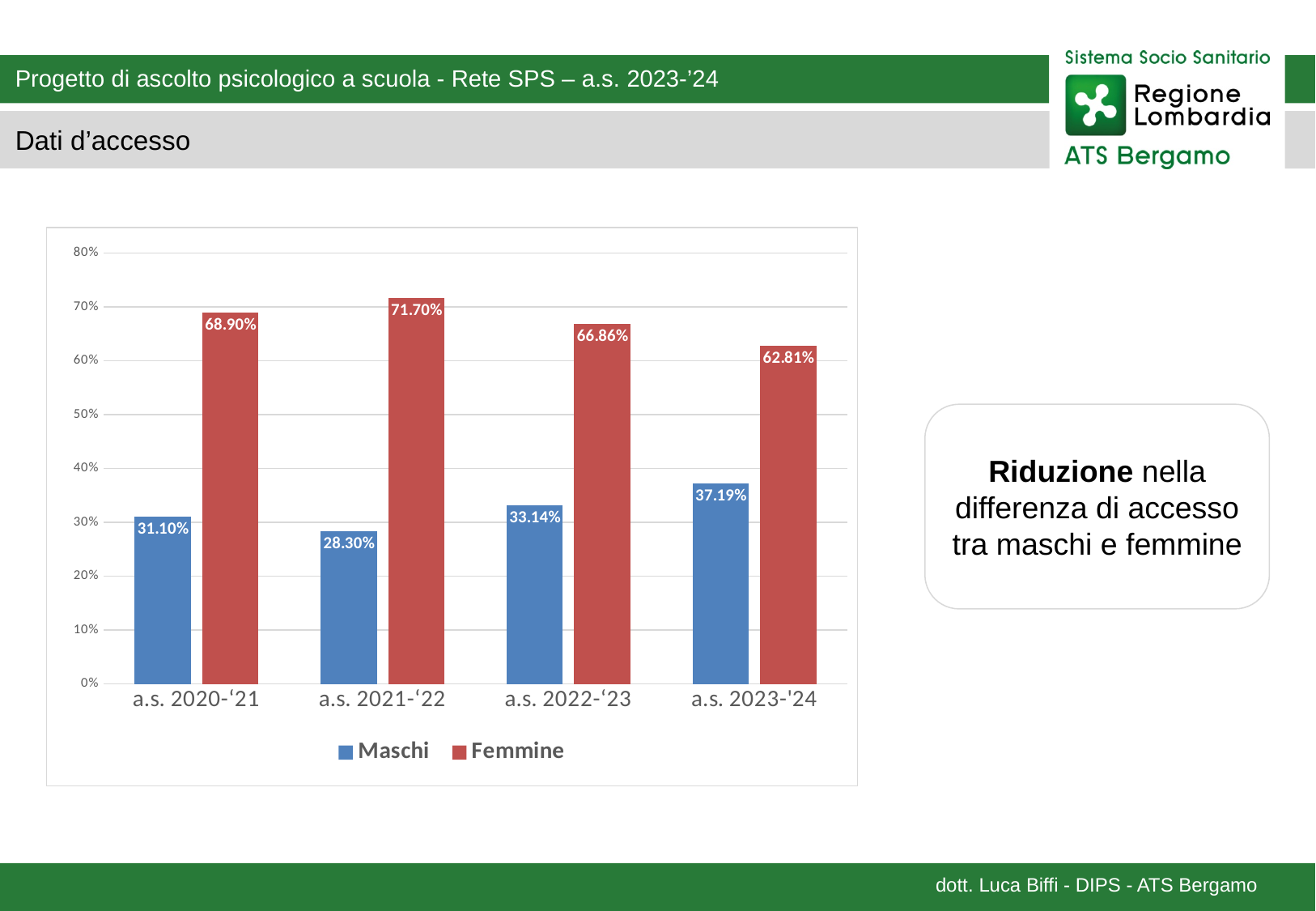
What is the value for Femmine in a.s. 2022-'23? 66.86% What kind of chart is shown on the slide? Bar chart What is the value for Maschi in a.s. 2020-'21? 31.10% Does the Femmine value rise or fall from a.s. 2021-'22 to a.s. 2023-'24? Fall What is the value for Femmine in a.s. 2021-'22? 71.70% In which school year is the Maschi value lowest? a.s. 2021-'22 How many series does the legend list? 2 In which school year is the Femmine value highest? a.s. 2021-'22 What is the difference between the Femmine and Maschi values in a.s. 2023-'24? 25.62% How many school years are shown on the x axis? 4 Which is larger in a.s. 2020-'21, the Maschi value or the Femmine value? Femmine What is the value for Maschi in a.s. 2023-'24? 37.19%